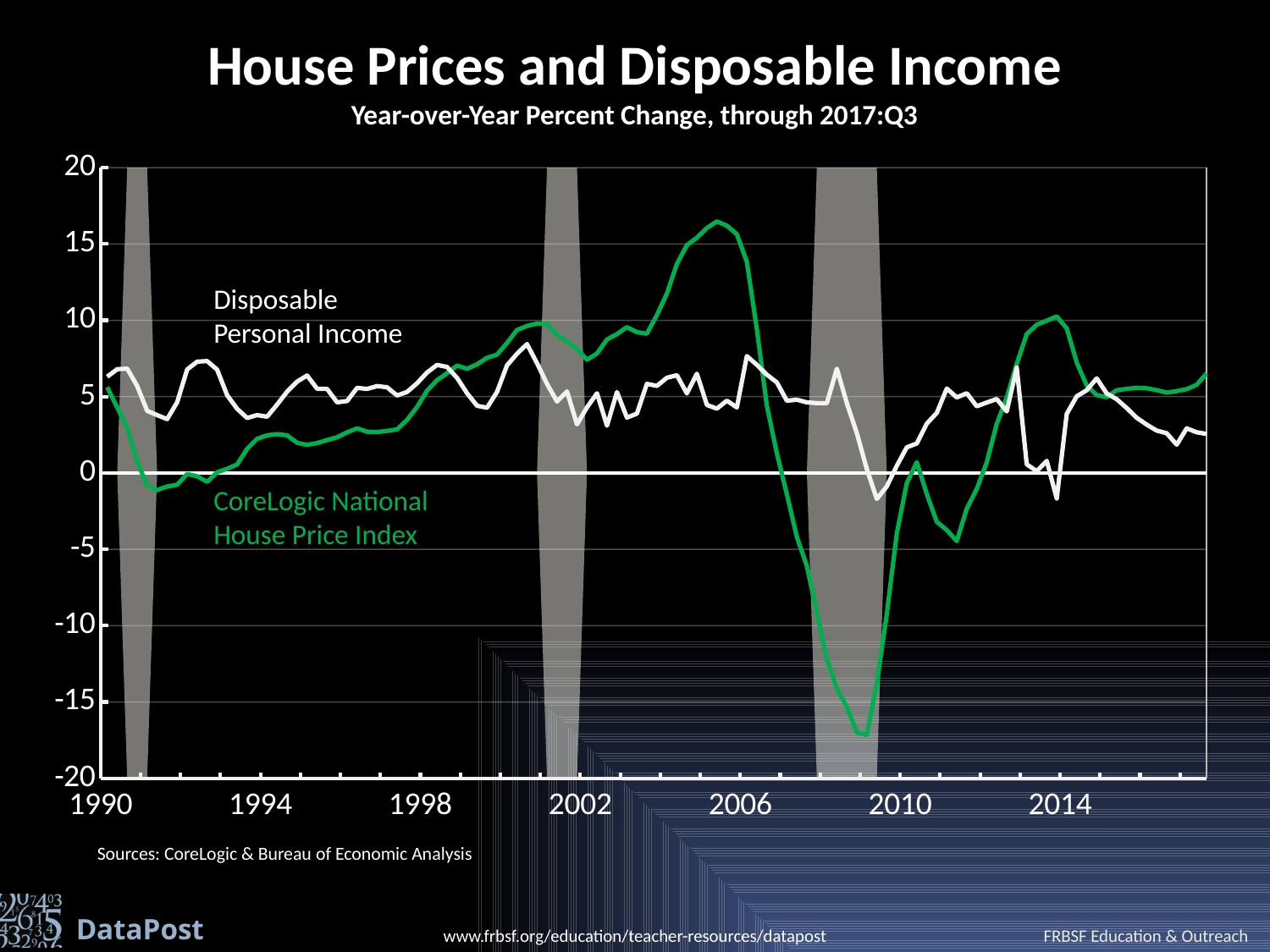
How many data series are plotted on the chart? 2 Is the value of Disposable Personal Income in 2005 greater or less than 10? less Is the value of the CoreLogic National House Price Index in 1994 greater or less than 5? less Which series reaches the lowest value anywhere on the chart? CoreLogic National House Price Index Is the value of the CoreLogic National House Price Index at its 2009 low greater or less than -15? less What colour is the line for the CoreLogic National House Price Index? Green In 2005, which series has the higher value: Disposable Personal Income or the CoreLogic National House Price Index? CoreLogic National House Price Index Does the CoreLogic National House Price Index rise or fall between 2006 and 2009? Fall What is the title of the chart? House Prices and Disposable Income What kind of chart is shown on the slide? Line chart